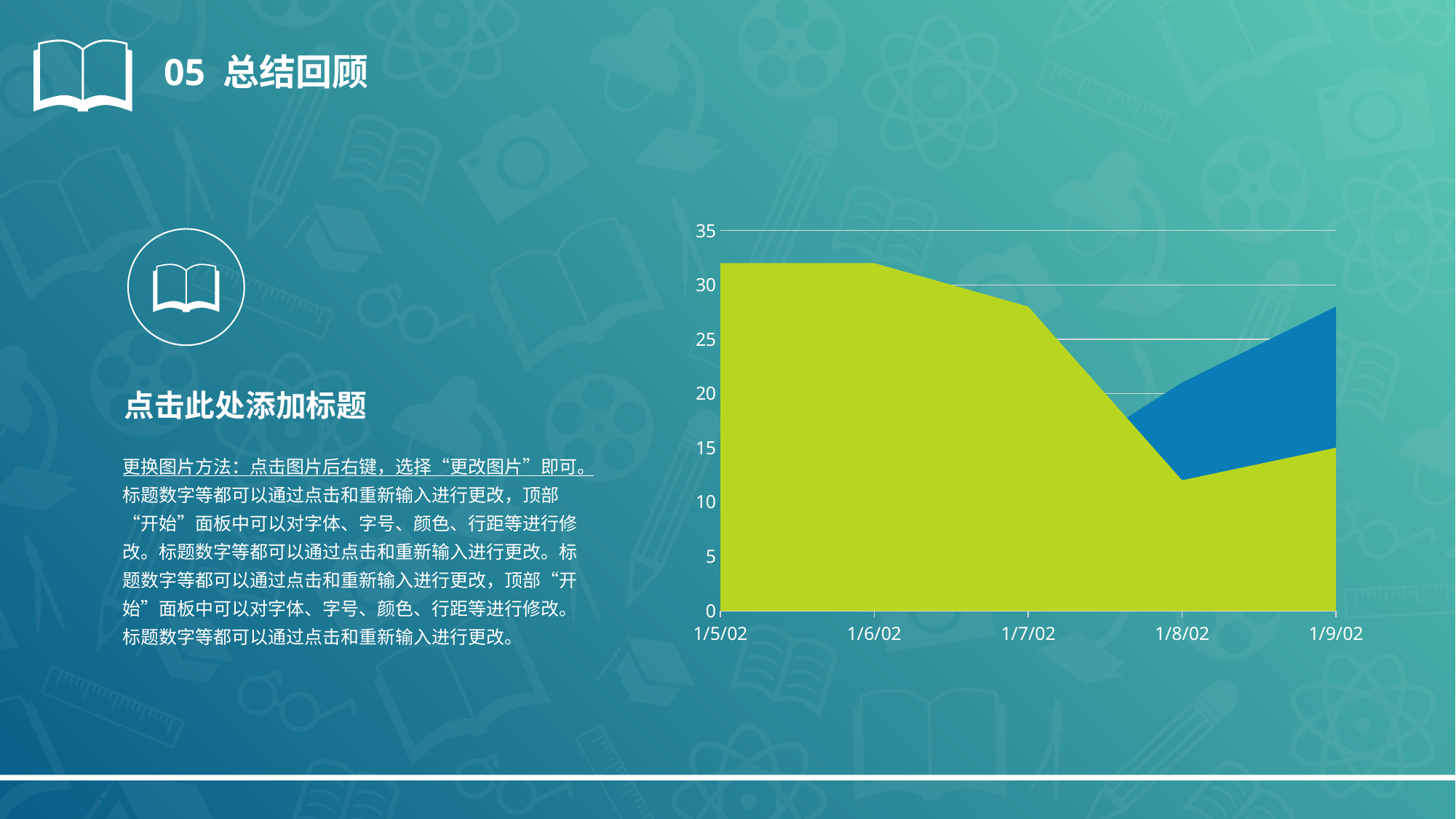
At which date is the green series at its lowest? 1/8/02 Is the value of the green series at 1/7/02 greater or less than 25? greater Is the value of the green series at 1/5/02 greater or less than 30? greater Does the green series rise or fall from 1/5/02 to 1/8/02? fall Is the value of the green series at 1/8/02 greater or less than 15? less Which is larger for the green series: the value at 1/5/02 or the value at 1/8/02? 1/5/02 How many dates are labelled on the x axis of the chart? 5 What is the first date label on the x axis of the chart? 1/5/02 What kind of chart is shown on the slide? area chart What is the highest value shown on the y axis of the chart? 35